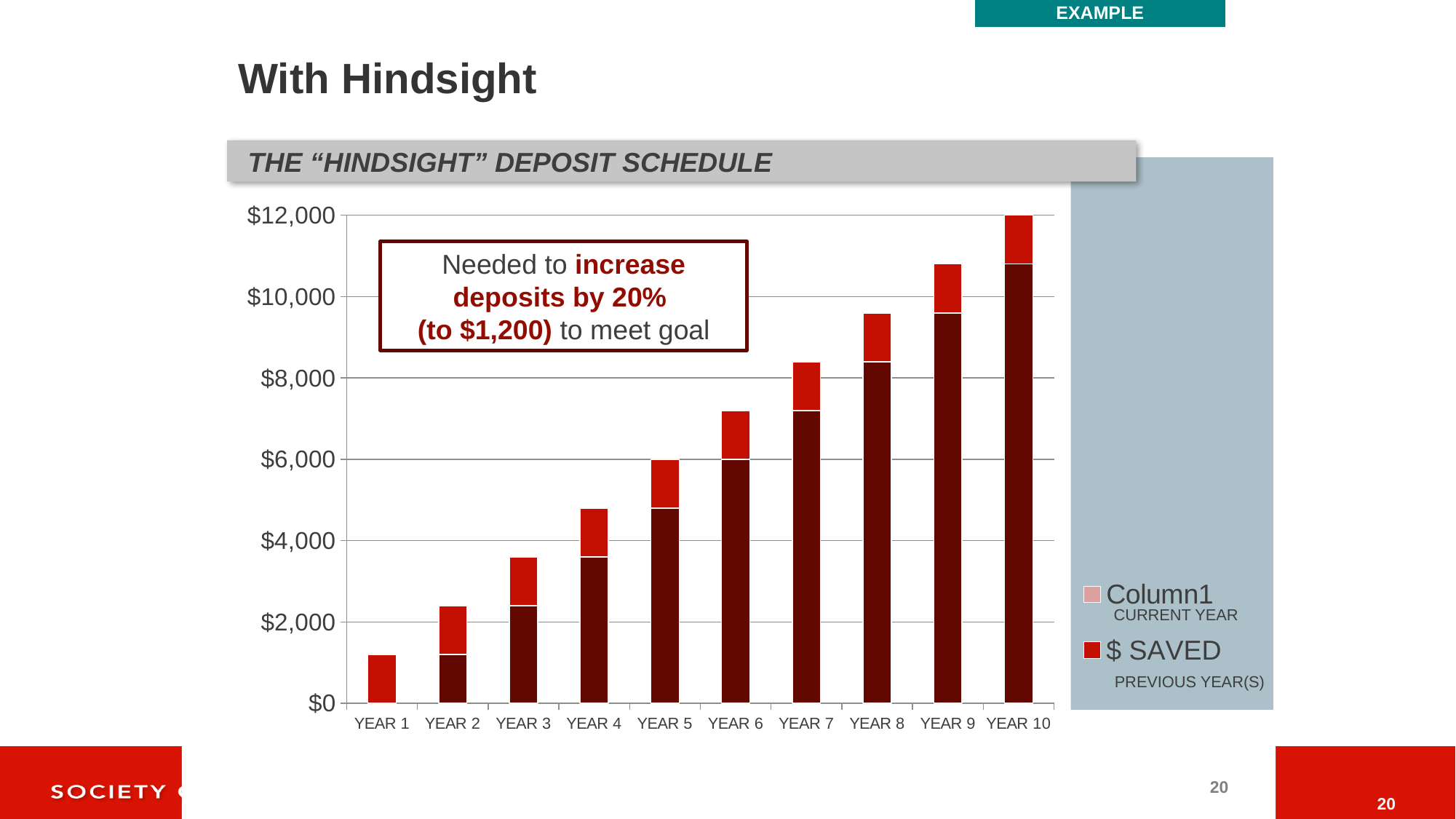
Do the stacked bar totals rise or fall from YEAR 1 to YEAR 10? Rise What kind of chart is shown on the slide? Bar chart Is the total for YEAR 9 greater or less than $10,000? greater Which year has the tallest stacked bar in the chart? YEAR 10 How many years (categories) are shown on the x axis of the chart? 10 Is the total for YEAR 8 greater or less than $10,000? less What is the total height of the stacked bar for YEAR 5? $6,000 Which year has the shortest stacked bar in the chart? YEAR 1 How many series does the chart's legend list? 2 What is the total height of the stacked bar for YEAR 10? $12,000 Is the total for YEAR 1 greater or less than $2,000? less What is the title shown above the chart? THE "HINDSIGHT" DEPOSIT SCHEDULE